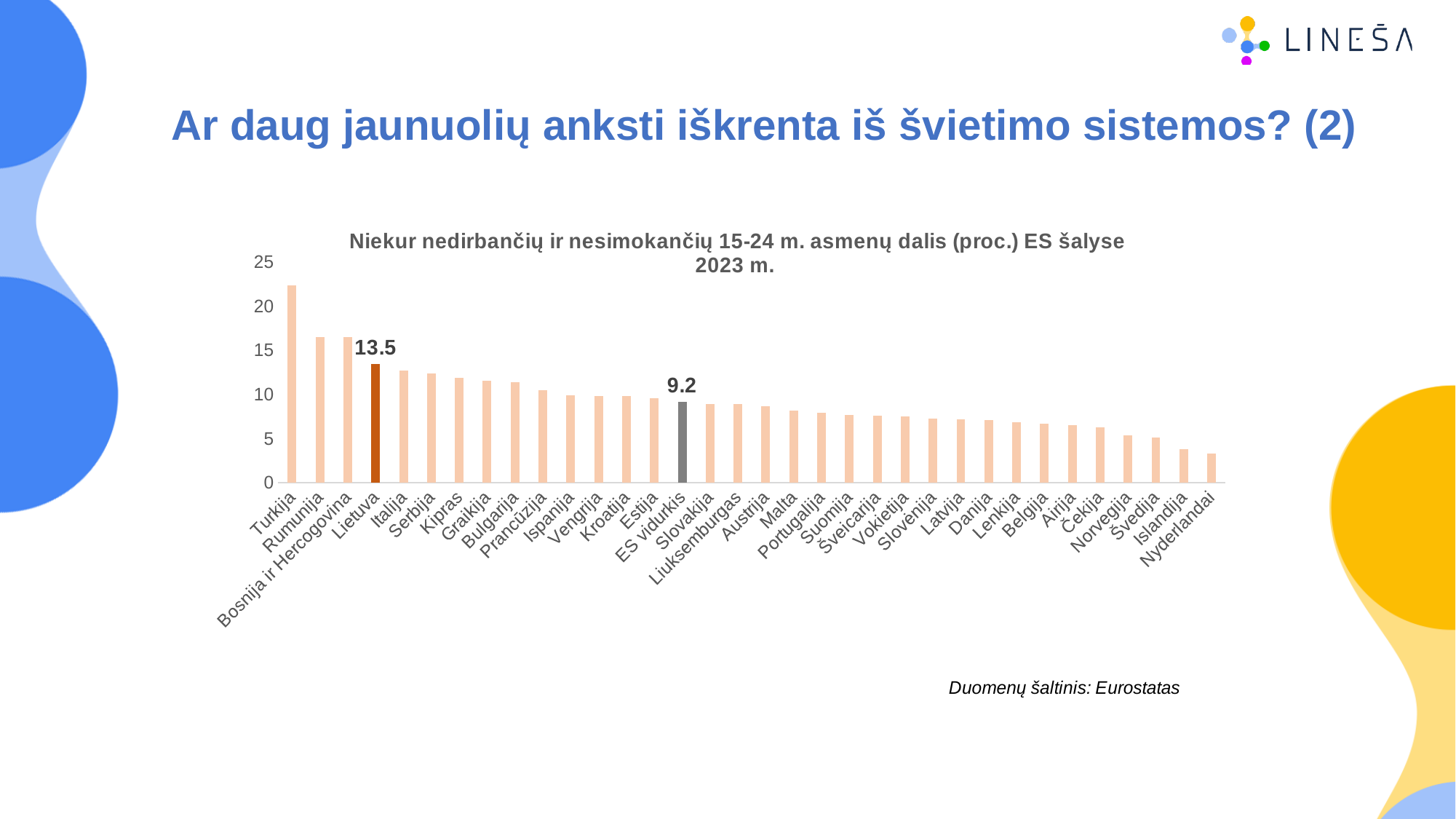
Is the value for Turkija greater or less than 20? greater What is the title of the chart? Niekur nedirbančių ir nesimokančių 15-24 m. asmenų dalis (proc.) ES šalyse 2023 m. What is the value shown for ES vidurkis? 9.2 What is the difference between the values for Lietuva and ES vidurkis? 4.3 Which country has the lowest value in the chart? Nyderlandai What kind of chart is shown on the slide? Bar chart Is the value for Nyderlandai greater or less than 5? less Is the value for Rumunija greater or less than 15? greater Which is larger, the value for Lietuva or the value for ES vidurkis? Lietuva What is the value shown for Lietuva? 13.5 Which country has the highest value in the chart? Turkija Do the values rise or fall moving from left to right along the x axis? fall